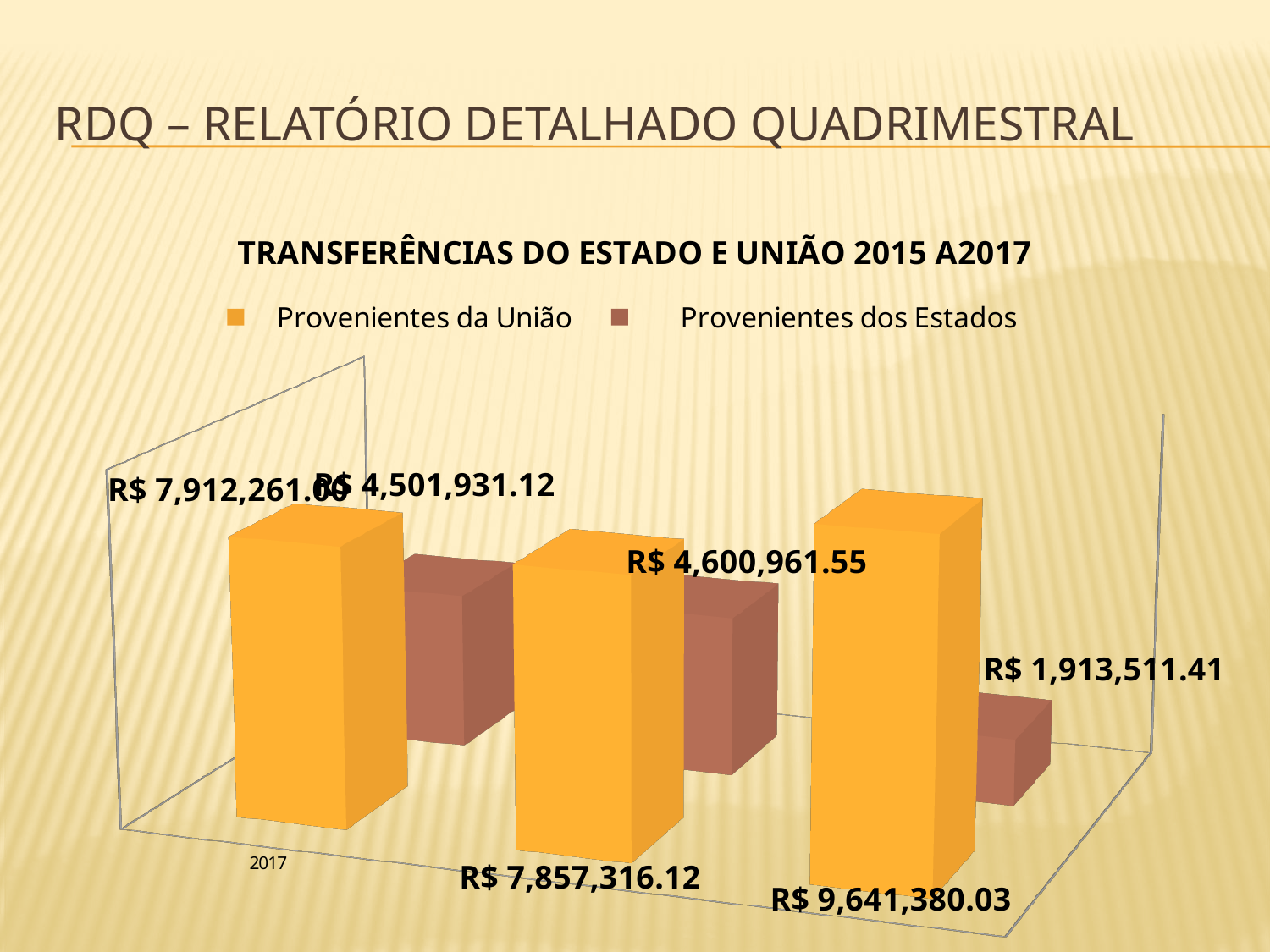
What kind of chart is shown on the slide? Bar chart What are the two series named in the legend? Provenientes da União and Provenientes dos Estados What is the value of the Provenientes dos Estados bar in the rightmost group? R$ 1,913,511.41 How many series does the legend list? 2 What is the title of the chart? TRANSFERÊNCIAS DO ESTADO E UNIÃO 2015 A2017 How many groups of bars are plotted in the chart? 3 Which group has the highest Provenientes da União bar? The rightmost group In the rightmost group, what is the difference between the Provenientes da União value and the Provenientes dos Estados value? R$ 7,727,868.62 Which group has the lowest Provenientes dos Estados bar? The rightmost group What is the value of the Provenientes da União bar in the middle group? R$ 7,857,316.12 What is the value of the Provenientes da União bar in the rightmost group? R$ 9,641,380.03 What is the value of the Provenientes dos Estados bar in the middle group? R$ 4,600,961.55